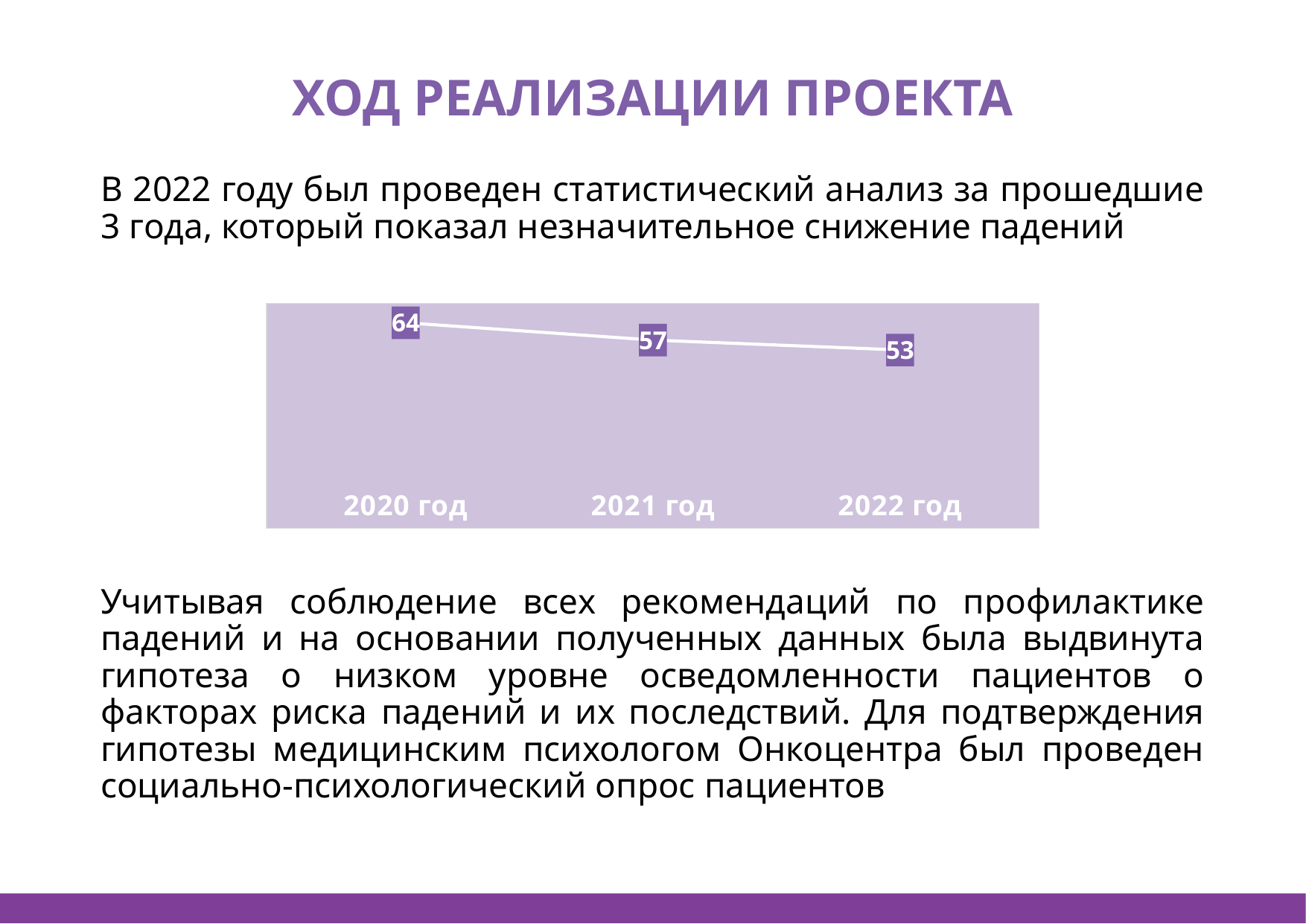
What kind of chart is shown on the slide? line chart What is the value for 2020 год? 64 What is the difference between the values for 2020 год and 2022 год? 11 What is the difference between the values for 2020 год and 2021 год? 7 What is the label of the first category on the x axis? 2020 год Which year has the lowest value? 2022 год Do the values rise or fall from 2020 год to 2022 год? fall Which is larger, the value for 2021 год or the value for 2022 год? 2021 год How many data points are plotted on the chart? 3 Which year has the highest value? 2020 год What is the value for 2022 год? 53 What is the value for 2021 год? 57